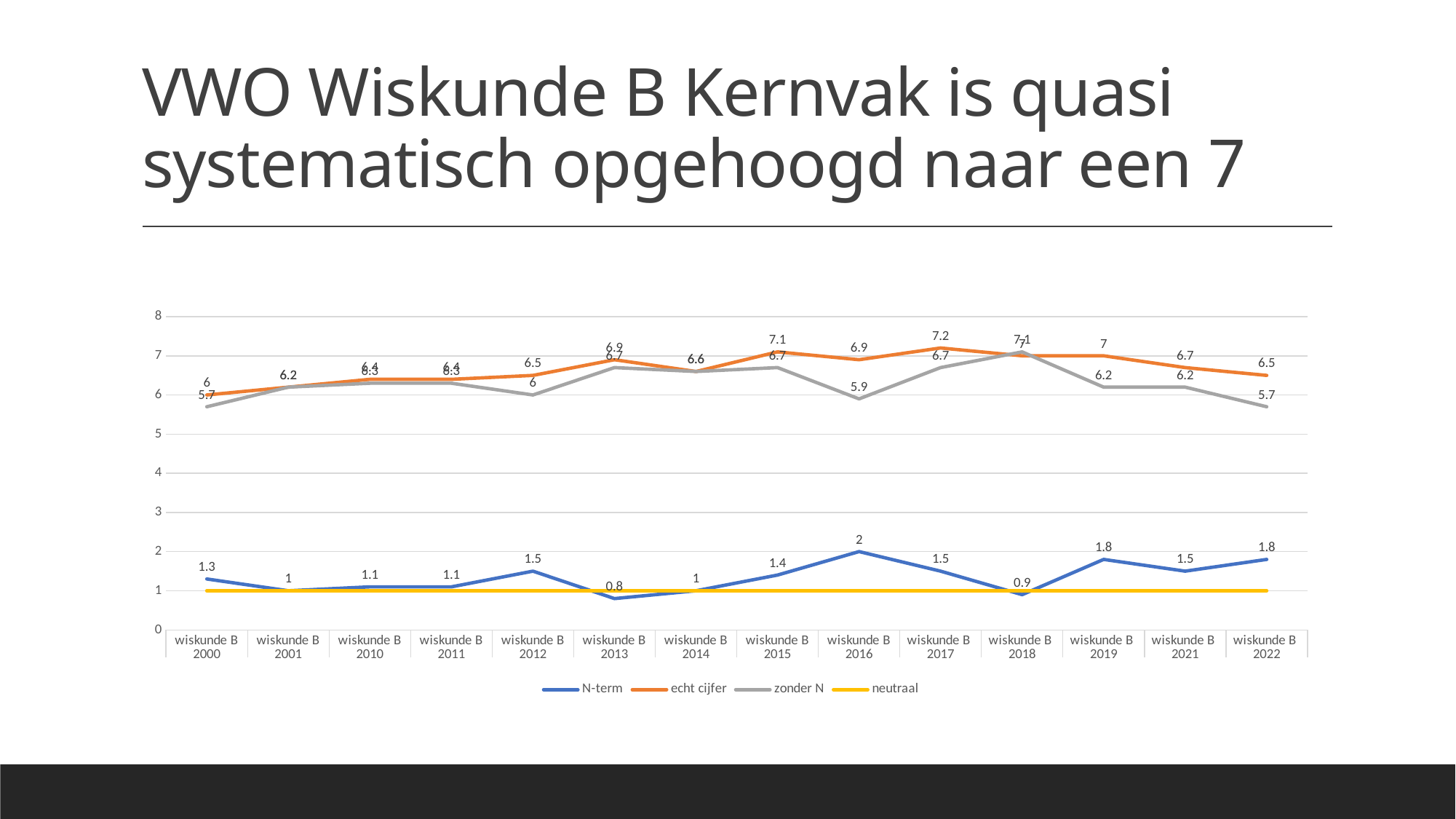
In which category does the N-term series have its lowest value? wiskunde B 2013 What is the value of the zonder N series for wiskunde B 2016? 5.9 In which category does the N-term series reach its highest value? wiskunde B 2016 In which category does the echt cijfer series reach its highest value? wiskunde B 2017 Is the value of the neutraal series greater or less than 2? less How many categories are shown on the x axis? 14 How many series does the legend list? 4 What is the value of the N-term series for wiskunde B 2019? 1.8 What is the difference between echt cijfer and zonder N for wiskunde B 2016? 1 What is the value of the N-term series for wiskunde B 2016? 2 What is the value of the echt cijfer series for wiskunde B 2017? 7.2 For wiskunde B 2022, which is larger: echt cijfer or zonder N? echt cijfer